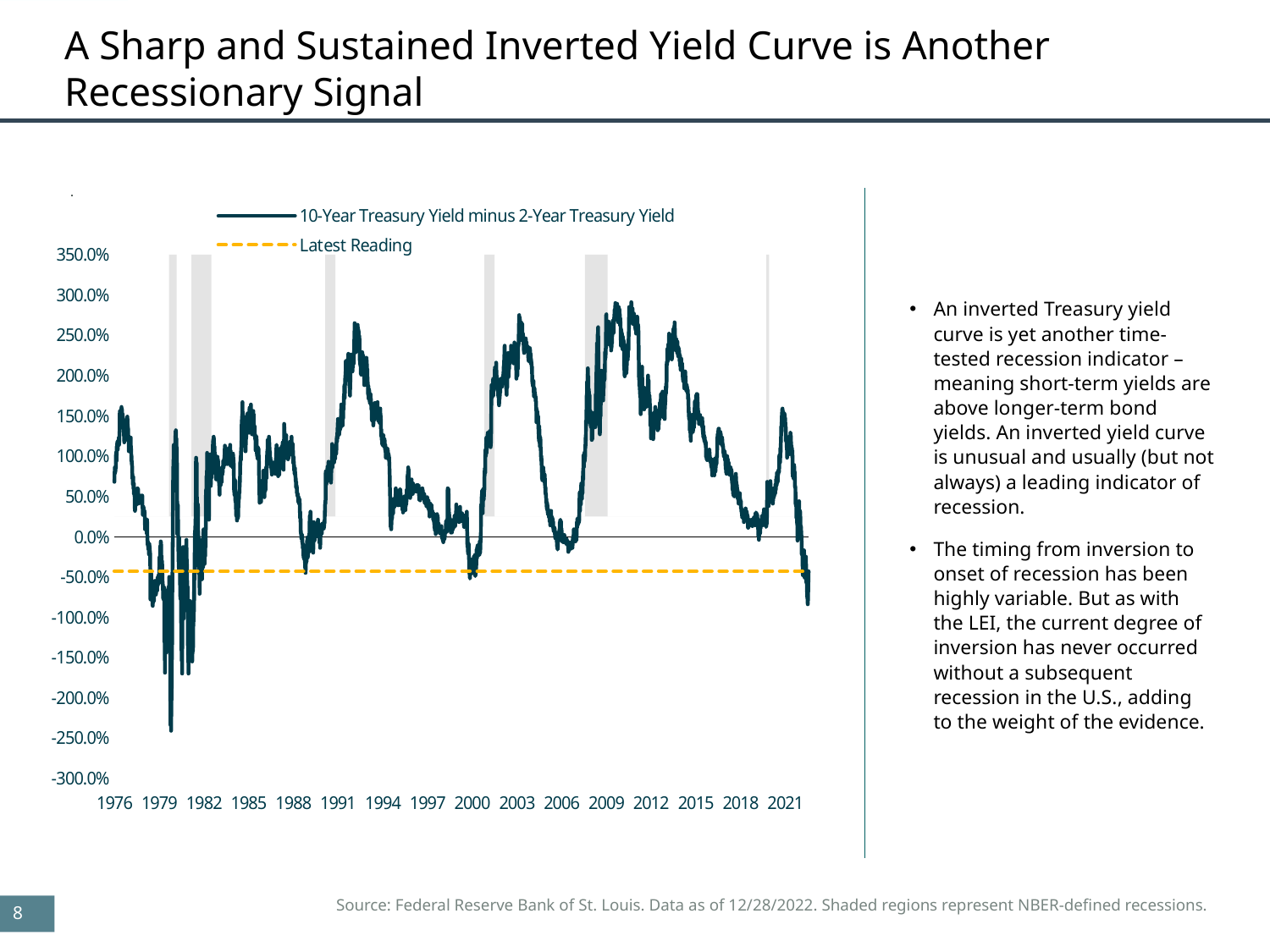
What is the highest value shown on the y axis of the chart? 350.0% Is the peak of the 10-Year minus 2-Year Treasury Yield line around 2010 greater or less than 250.0%? greater What is the name of the solid line series in the chart legend? 10-Year Treasury Yield minus 2-Year Treasury Yield Is the peak of the 10-Year minus 2-Year Treasury Yield line around 1992 greater or less than 200.0%? greater How many year labels are shown on the x axis of the chart? 16 In which period does the 10-Year minus 2-Year Treasury Yield line reach its lowest value: around 1980 or around 2000? Around 1980 Does the 10-Year minus 2-Year Treasury Yield line generally rise or fall between 2012 and 2019? Fall Is the Latest Reading dashed line greater or less than 0.0%? less How many series does the chart legend list? 2 What does the dashed horizontal line in the chart represent, according to the legend? Latest Reading What kind of chart is shown on the slide? Line chart